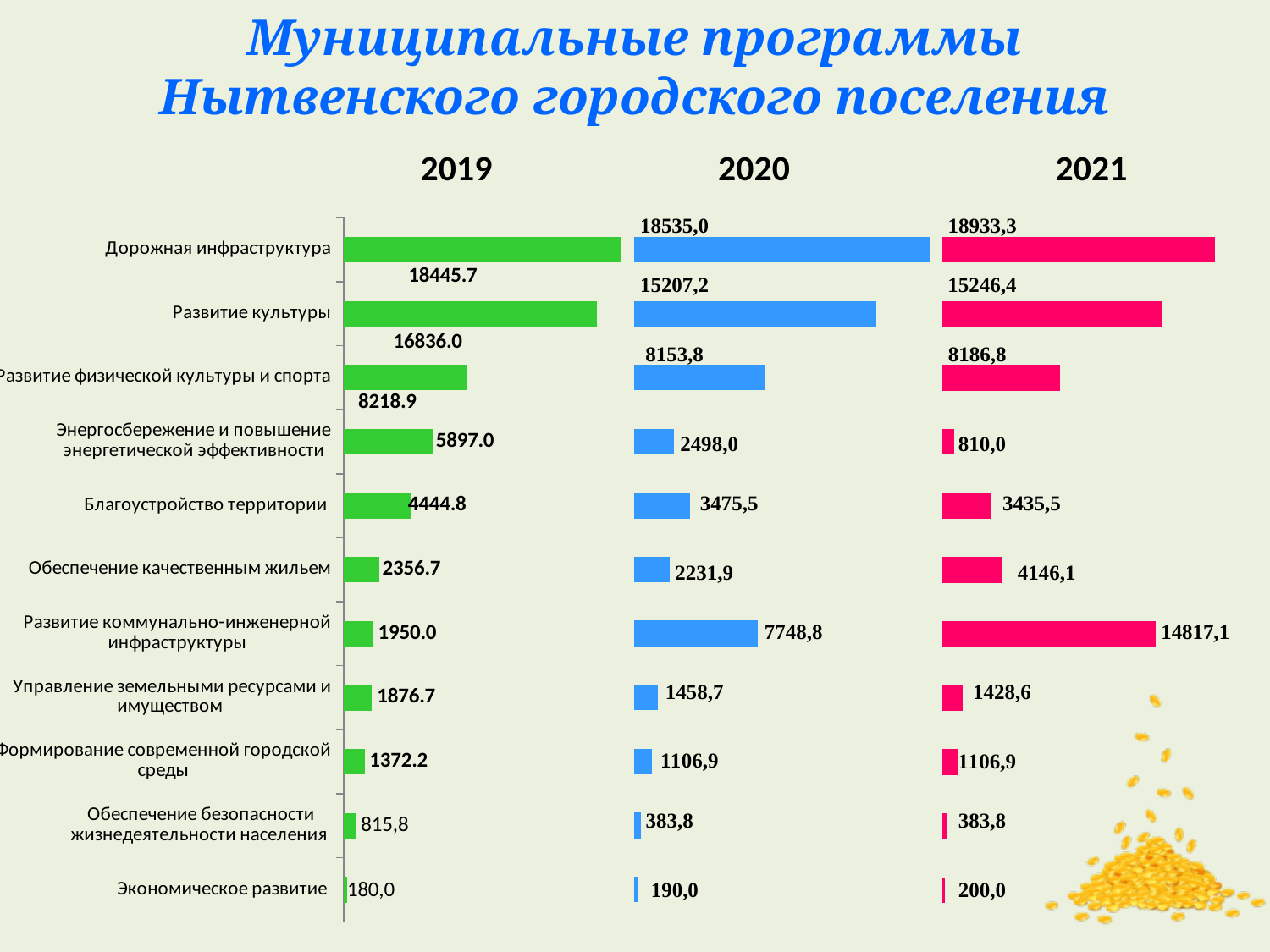
In the 2021 chart, what is the value for Энергосбережение и повышение энергетической эффективности? 810,0 In the 2020 chart, which is larger: Благоустройство территории or Обеспечение качественным жильем? Благоустройство территории What kind of chart is used for the 2020 data? bar chart In the 2021 chart, which category has the highest value? Дорожная инфраструктура What colour are the bars in the 2021 chart? pink/red In the 2021 chart, how much larger is Развитие коммунально-инженерной инфраструктуры than in the 2020 chart? 7068,3 In the 2019 chart, what is the value for Экономическое развитие? 180,0 In the 2020 chart, what is the value for Развитие коммунально-инженерной инфраструктуры? 7748,8 In the 2019 chart, what is the value for Дорожная инфраструктура? 18445.7 In the 2021 chart, what is the difference between Дорожная инфраструктура and Развитие культуры? 3686,9 In the 2020 chart, which category has the lowest value? Экономическое развитие How many categories are shown in the 2019 chart? 11